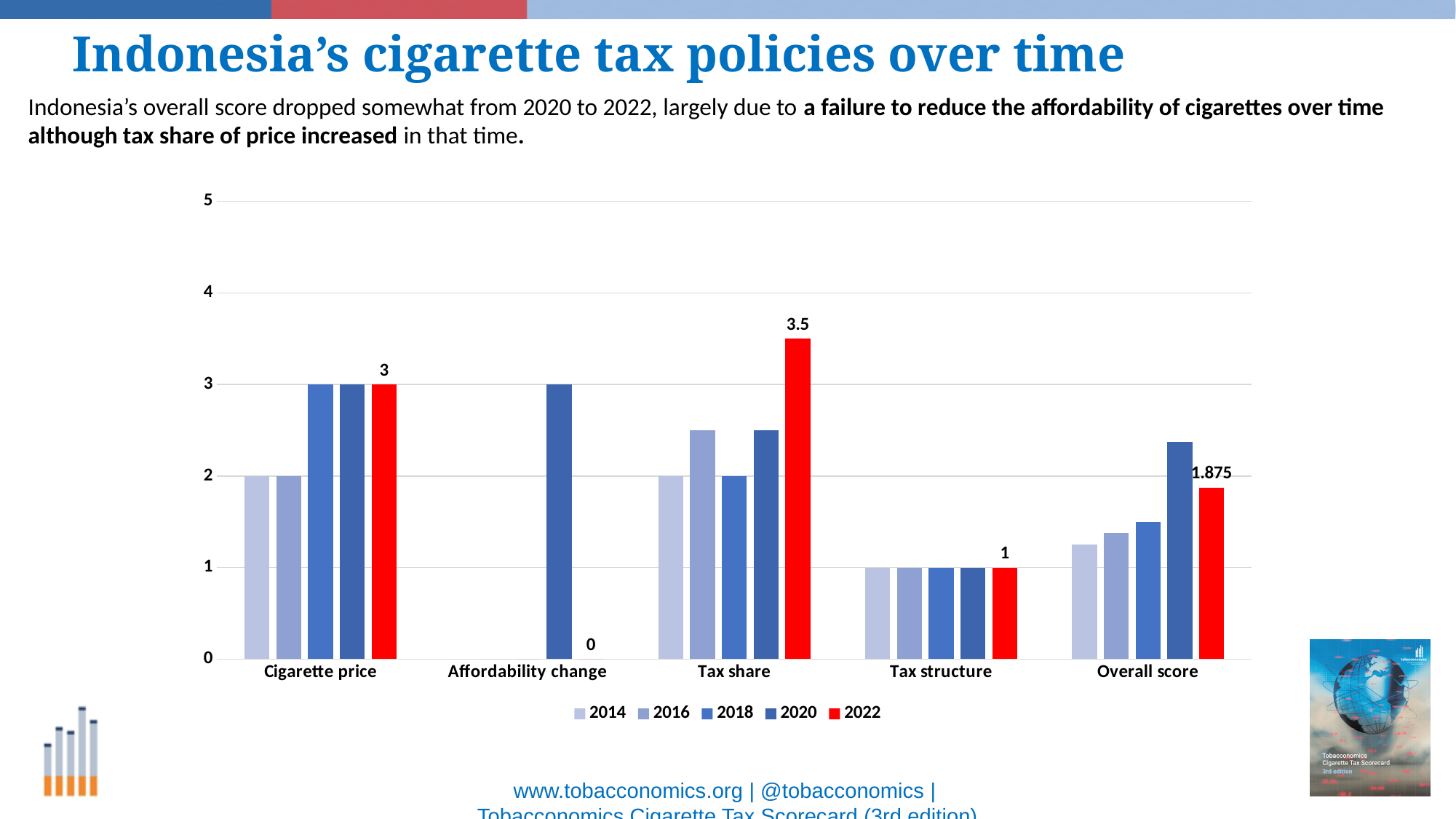
Among the 2022 bars, which category has the highest value? Tax share What is the 2020 value for Affordability change? 3 Which is larger in 2022: Tax share or Overall score? Tax share What is the 2022 value for Overall score? 1.875 What is the 2022 value for Affordability change? 0 Among the 2022 bars, which category has the lowest value? Affordability change How many categories are shown on the x axis? 5 What is the difference between the 2022 values for Tax share and Cigarette price? 0.5 What is the 2022 value for Tax share? 3.5 Is the 2020 value for Overall score greater or less than 2? greater How many series does the legend list? 5 What kind of chart is shown on the slide? bar chart